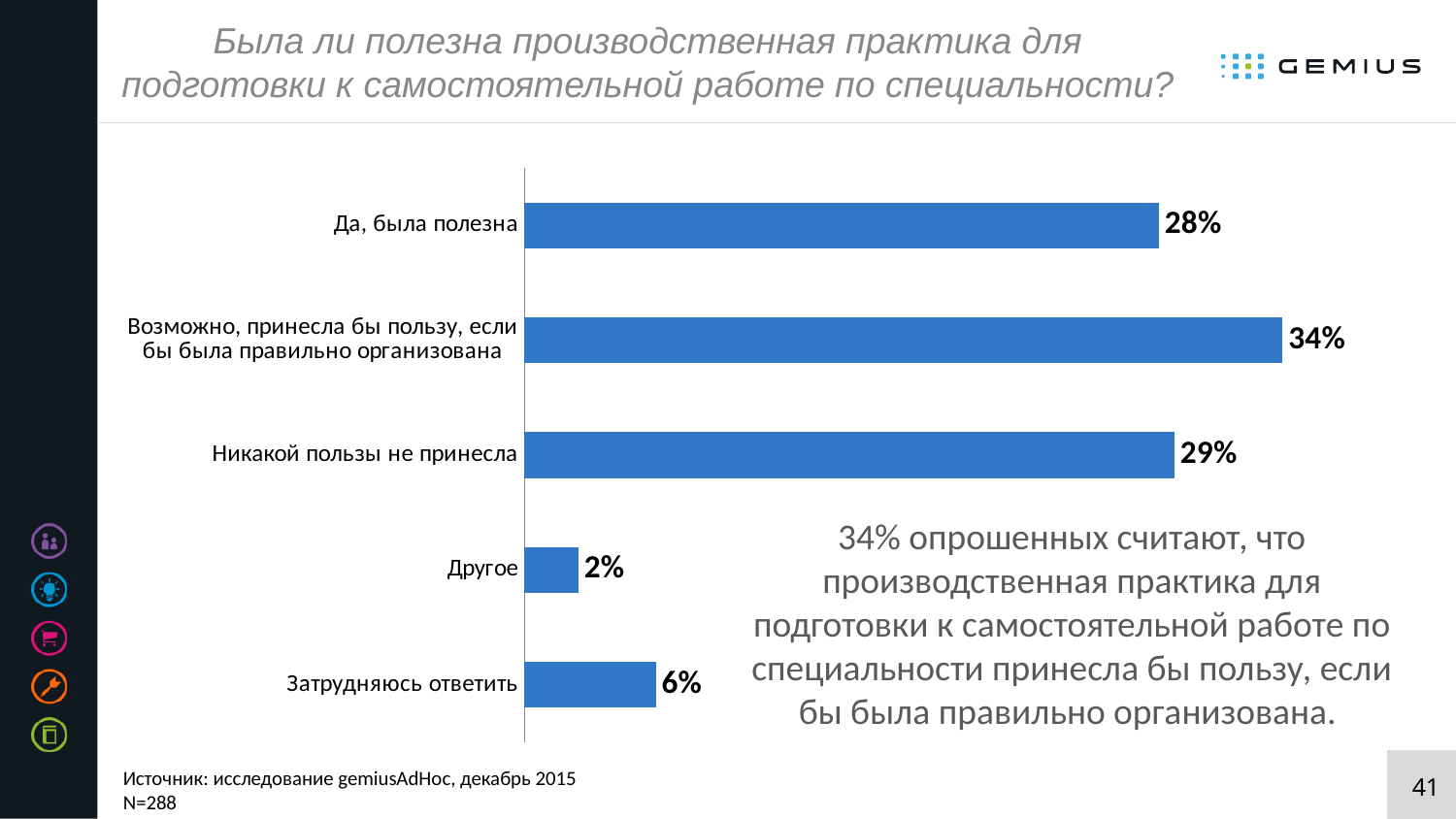
What kind of chart is shown on the slide? Bar chart What is the value for "Да, была полезна"? 28% How many categories are shown in the chart? 5 What is the difference between the values for "Возможно, принесла бы пользу, если бы была правильно организована" and "Да, была полезна"? 6% What is the value for "Никакой пользы не принесла"? 29% Which is larger: the value for "Затрудняюсь ответить" or the value for "Другое"? Затрудняюсь ответить Which category has the lowest value? Другое What is the sample size (N) stated on the slide? N=288 What is the value for "Возможно, принесла бы пользу, если бы была правильно организована"? 34% What is the value for "Другое"? 2% What is the value for "Затрудняюсь ответить"? 6% Which category has the highest value? Возможно, принесла бы пользу, если бы была правильно организована